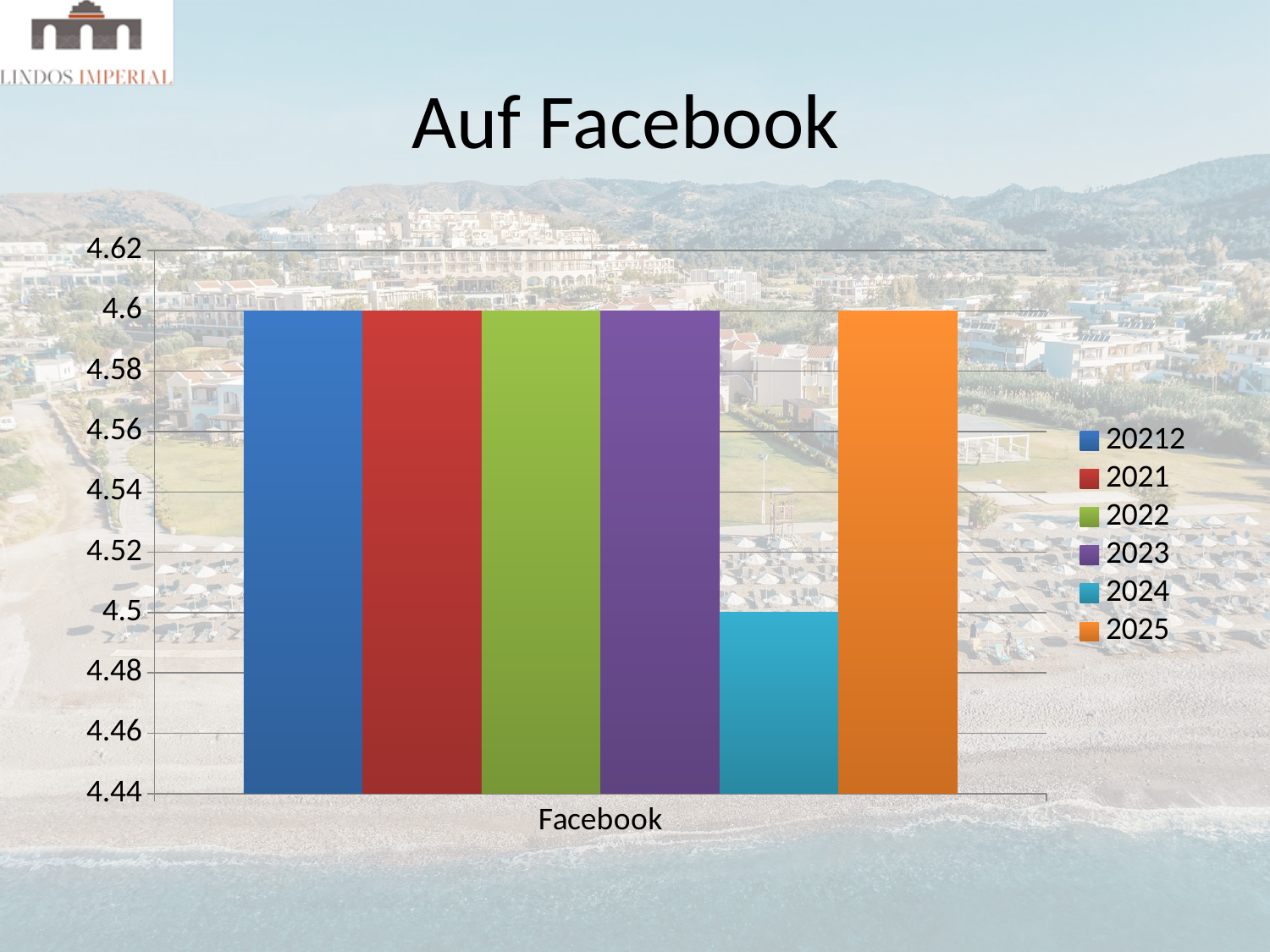
Which series has the lowest value in the chart? 2024 Is the value for 2025 greater or less than 4.54? greater How many series does the legend list? 6 What is the title of the slide? Auf Facebook Which is larger, the value for 2022 or the value for 2024? 2022 What is the value for the 2021 series in the chart? 4.6 What is the value for the 2024 series in the chart? 4.5 How many categories are shown on the x axis? 1 What is the value for the 2025 series in the chart? 4.6 What kind of chart is shown on the slide? bar chart Is the value for 2024 greater or less than 4.56? less What is the difference between the values for 2023 and 2024? 0.1